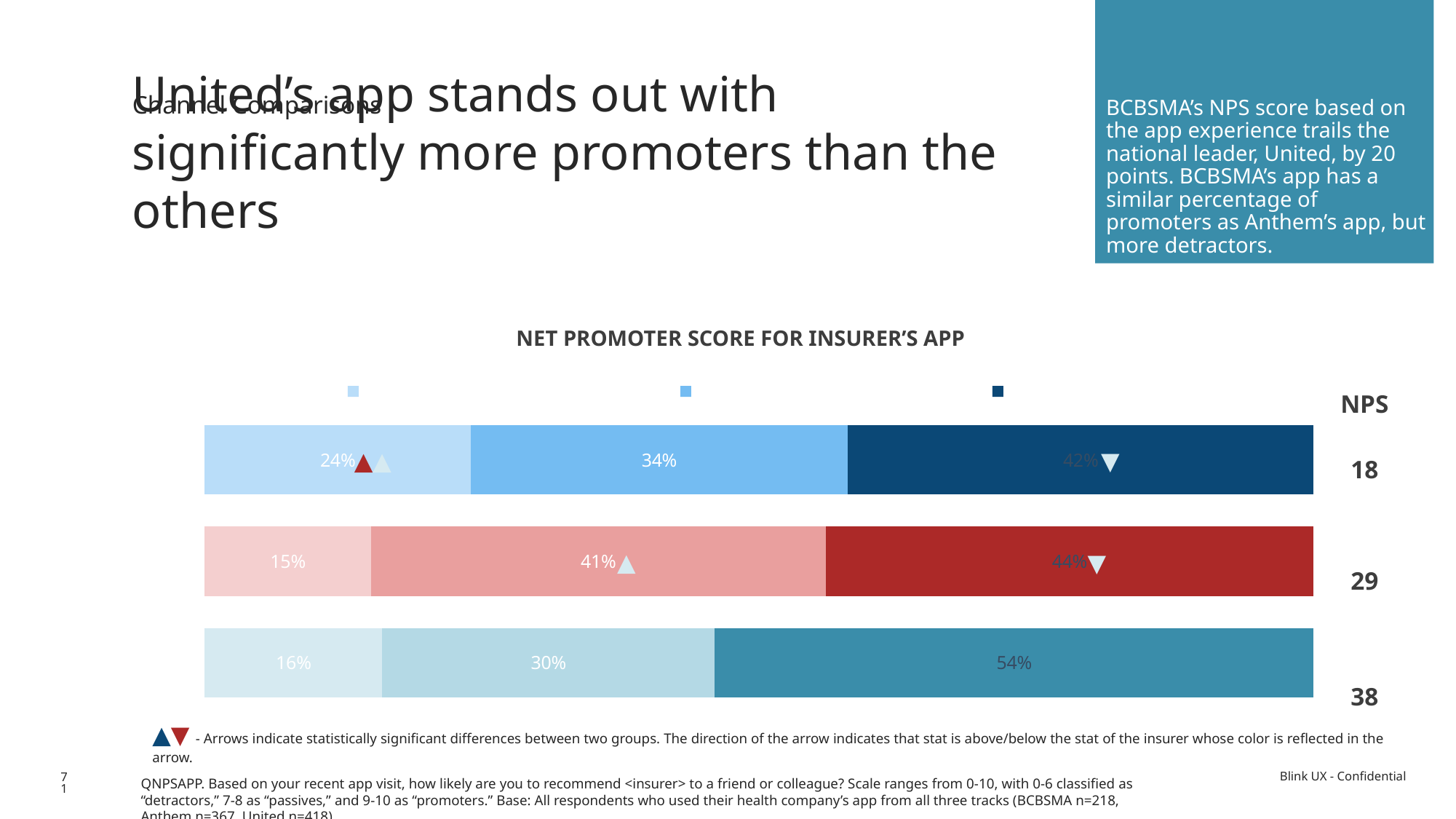
What is the title of the chart? NET PROMOTER SCORE FOR INSURER'S APP What kind of chart is shown on the slide? Stacked bar chart How many series does the legend show? 3 Which bar has the highest NPS value? The bottom bar (38) What is the difference between the NPS of the bottom bar and the NPS of the top bar? 20 What is the value of the middle segment of the middle (red) bar? 41% What NPS value is shown next to the bottom bar? 38 How many bars are plotted in the chart? 3 What is the value of the rightmost segment of the bottom bar? 54% Which is larger: the rightmost segment of the middle bar or the rightmost segment of the top bar? The middle bar (44%) What is the total of the three segments in the top bar? 100% What is the value of the leftmost segment of the top bar? 24%